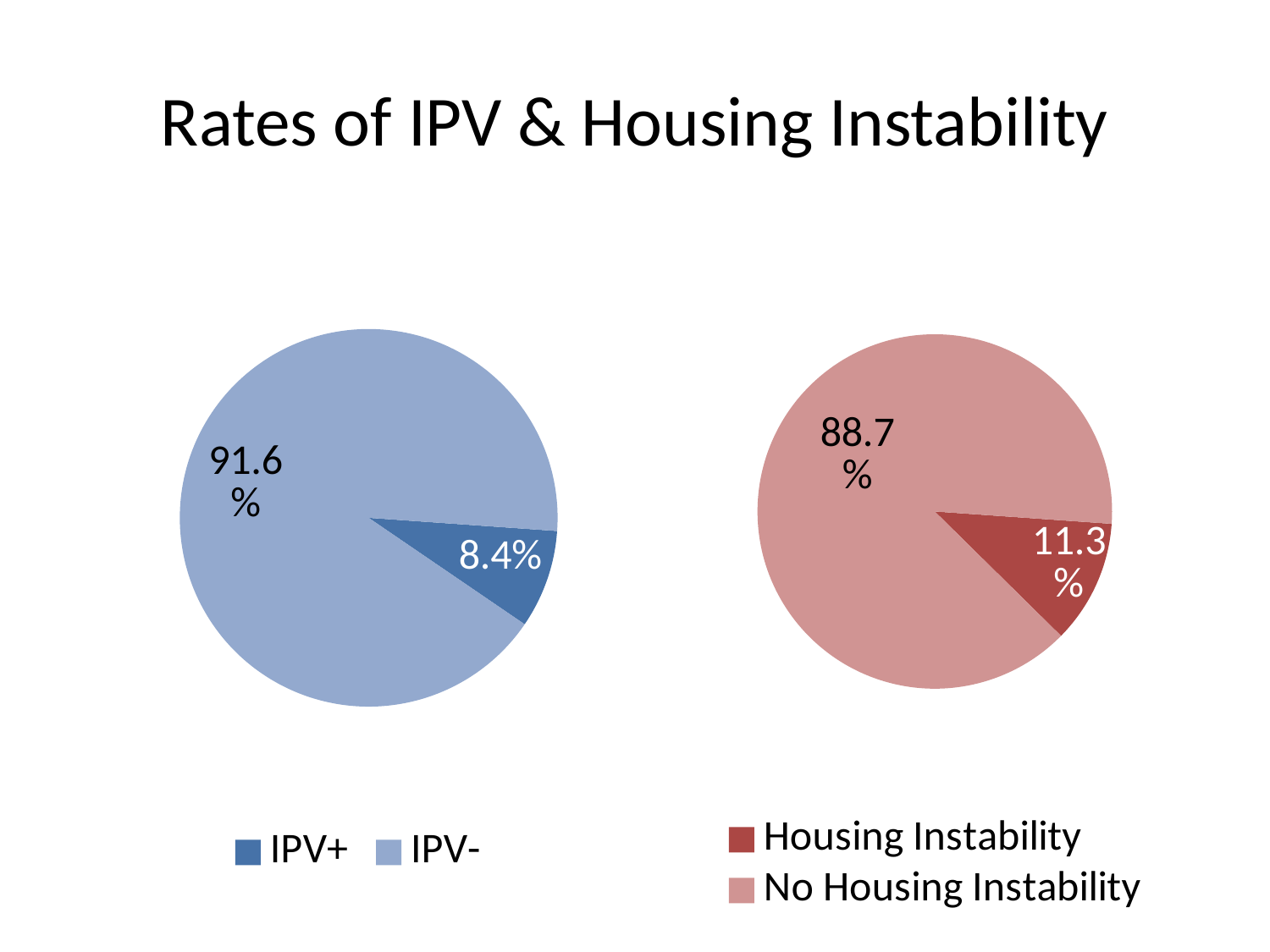
Which is larger: the IPV+ slice in the left pie chart or the Housing Instability slice in the right pie chart? Housing Instability How many slices does the right pie chart have? 2 In the left pie chart, what is the value for IPV-? 91.6% In the left pie chart, what is the value for IPV+? 8.4% In the right pie chart, what is the value for No Housing Instability? 88.7% What type of chart is the left chart? Pie chart In the right pie chart, which category has the smallest slice? Housing Instability What is the title of the slide containing the two pie charts? Rates of IPV & Housing Instability How many entries does the legend of the right pie chart list? 2 In the left pie chart, what is the difference between the IPV- and IPV+ values? 83.2% In the left pie chart, which category has the largest slice? IPV- In the right pie chart, what is the value for Housing Instability? 11.3%